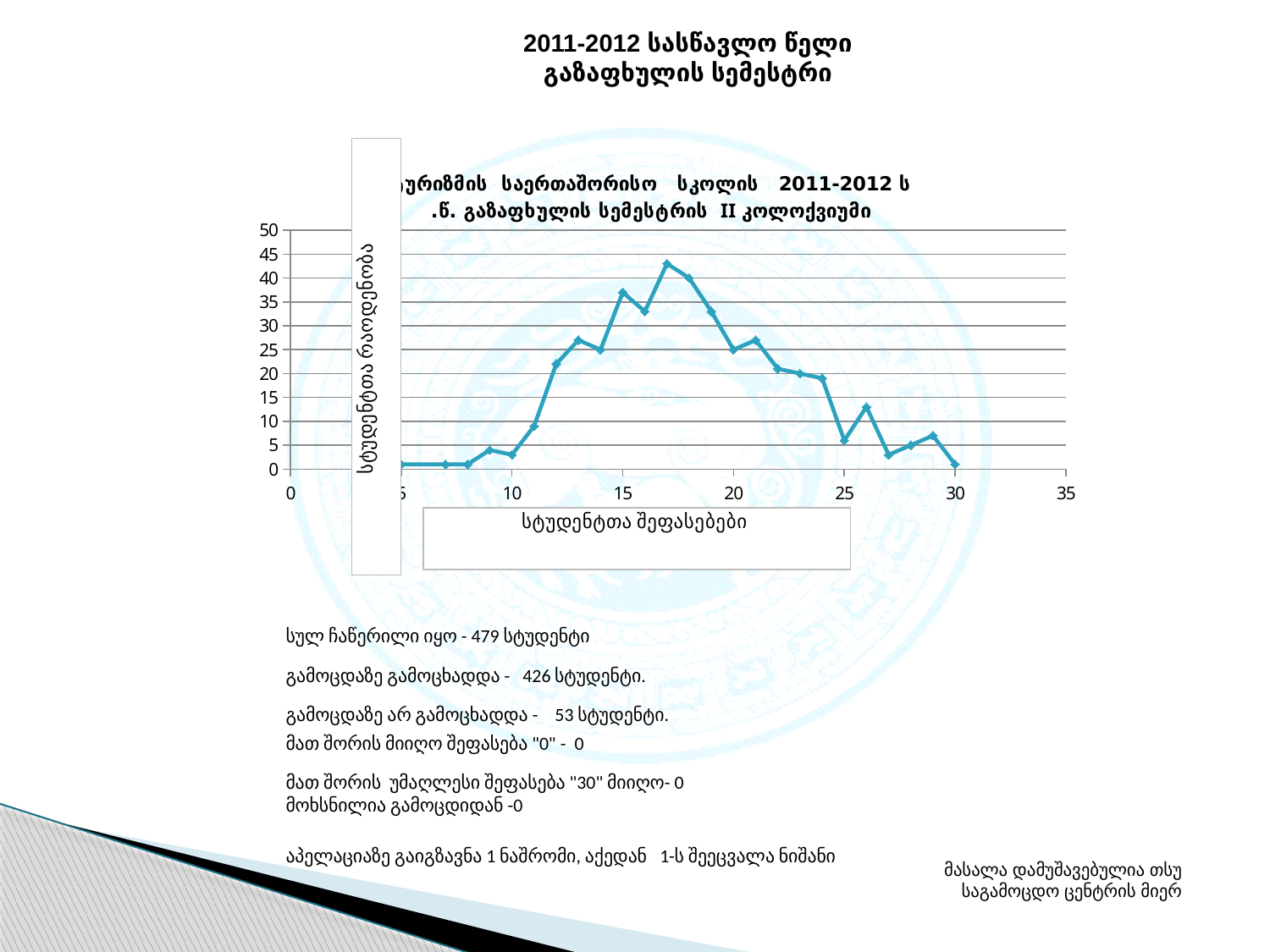
Is the value at x = 26 greater or less than 10? greater Is the value at x = 25 greater or less than 10? less Which has the larger value, x = 17 or x = 13? 17 What is the label on the vertical axis of the chart? სტუდენტთა რაოდენობა Is the value at x = 17 greater or less than 40? greater Does the line generally rise or fall between x = 10 and x = 17? rise What kind of chart is shown on the slide? line chart Which has the larger value, x = 19 or x = 21? 19 Does the line generally rise or fall between x = 17 and x = 25? fall At which x-axis value (student score) does the line reach its highest point? 17